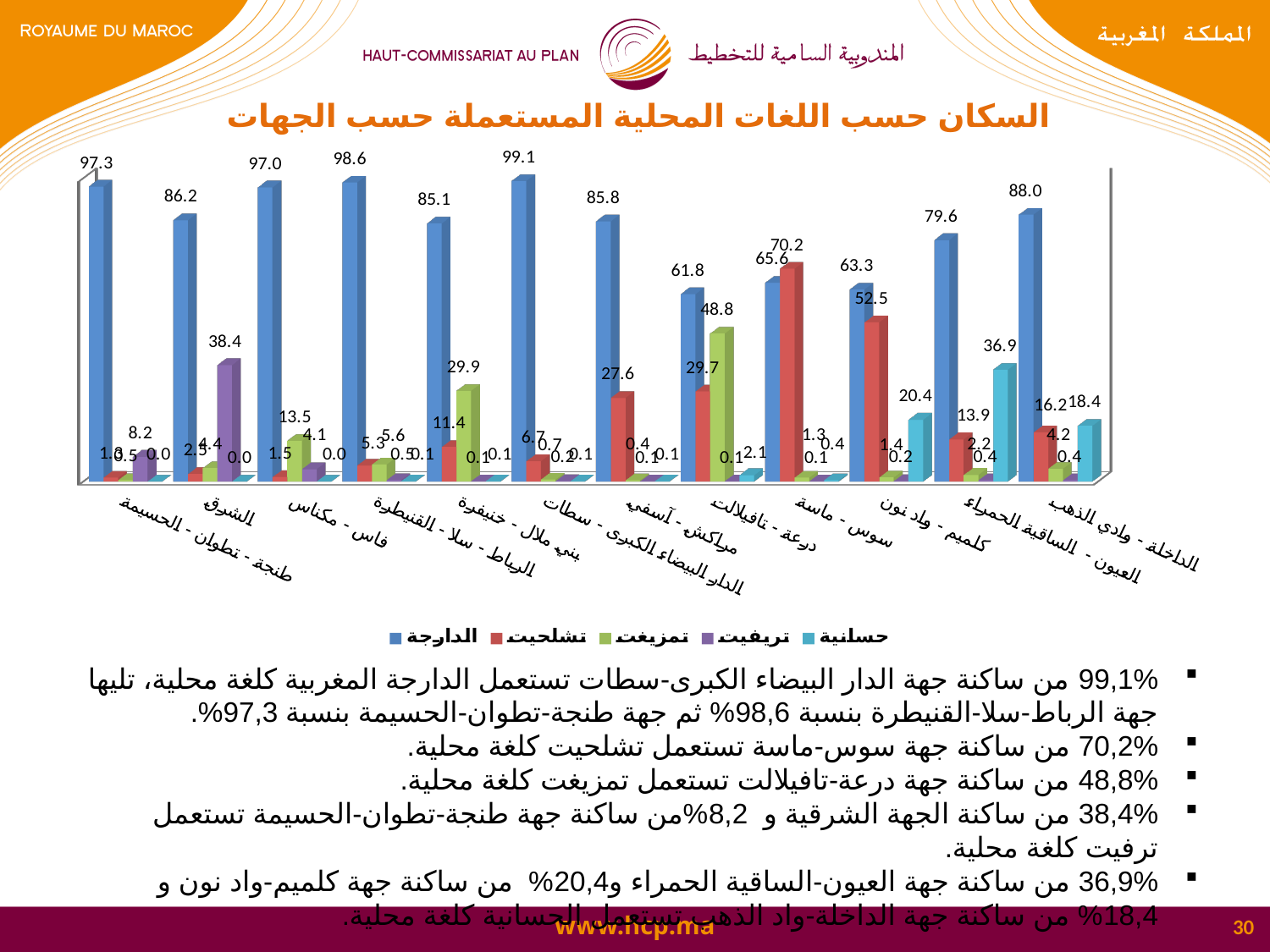
What is the difference between the الدارجة values for الدار البيضاء الكبرى - سطات and الرباط - سلا - القنيطرة? 0.5 Which region has the lowest value for الدارجة? درعة - تافيلالت What type of chart is shown on the slide? bar chart What is the value for تمزيغت in درعة - تافيلالت? 48.8 Which region has the highest value for تريفيت? الشرق Which region has the highest value for الدارجة? الدار البيضاء الكبرى - سطات How many regions are shown on the x axis of the chart? 12 What is the value for حسانية in كلميم - واد نون? 20.4 How many series does the legend list? 5 What is the value for الدارجة in الدار البيضاء الكبرى - سطات? 99.1 What is the value for تشلحيت in سوس - ماسة? 70.2 In سوس - ماسة, which is larger: the value for تشلحيت or the value for الدارجة? تشلحيت